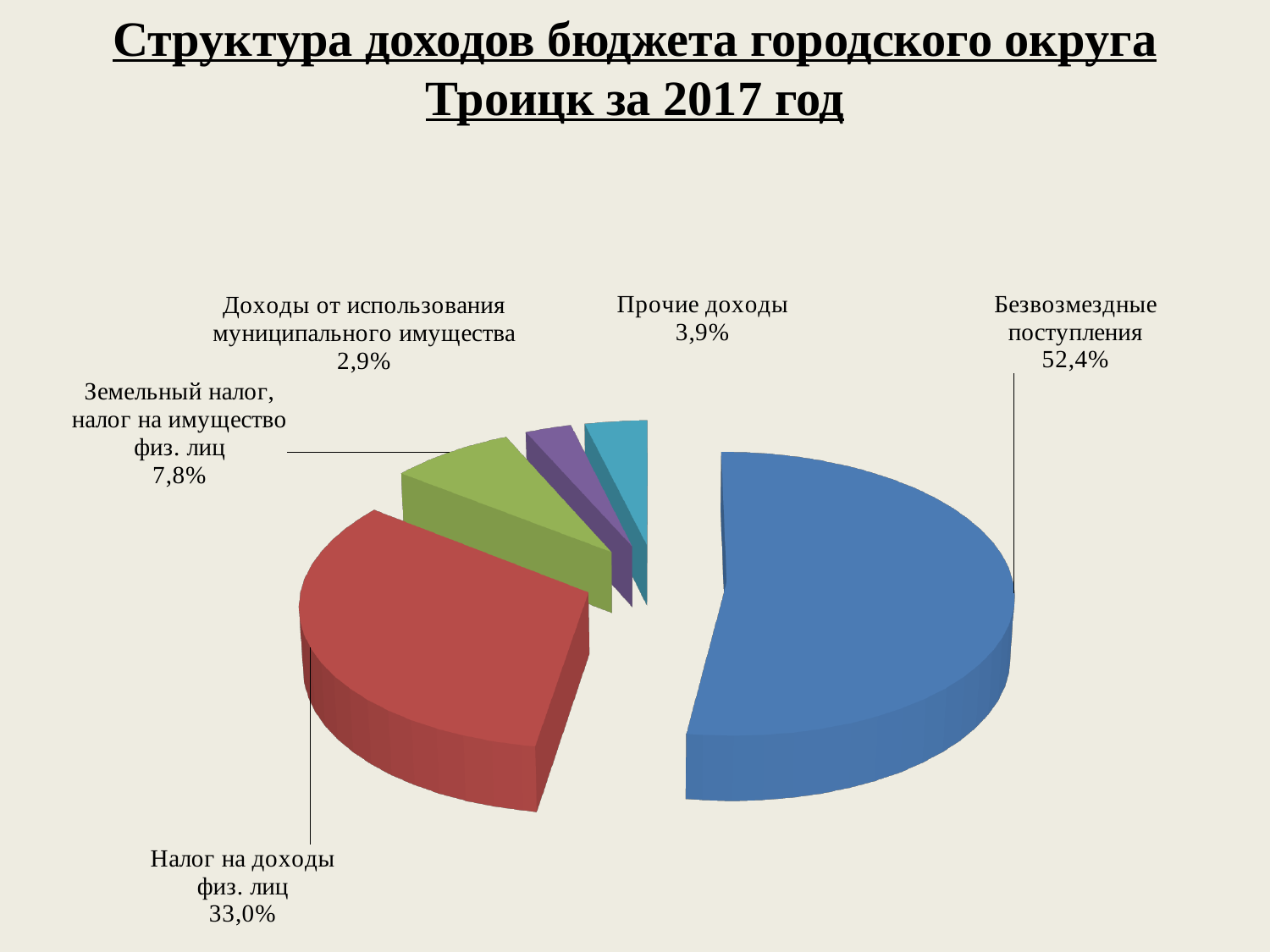
What is the difference in percentage points between "Безвозмездные поступления" and "Налог на доходы физ. лиц"? 19,4 What share of the budget income is "Налог на доходы физ. лиц"? 33,0% What share of the budget income is "Безвозмездные поступления"? 52,4% What share is shown for "Земельный налог, налог на имущество физ. лиц"? 7,8% How many slices does the pie chart have? 5 What kind of chart is shown on the slide? Pie chart Which category has the smallest share of the pie? Доходы от использования муниципального имущества Which is larger: "Прочие доходы" or "Доходы от использования муниципального имущества"? Прочие доходы What share is shown for "Прочие доходы"? 3,9% What share is shown for "Доходы от использования муниципального имущества"? 2,9% Which category has the largest share of the pie? Безвозмездные поступления What is the title of the slide? Структура доходов бюджета городского округа Троицк за 2017 год